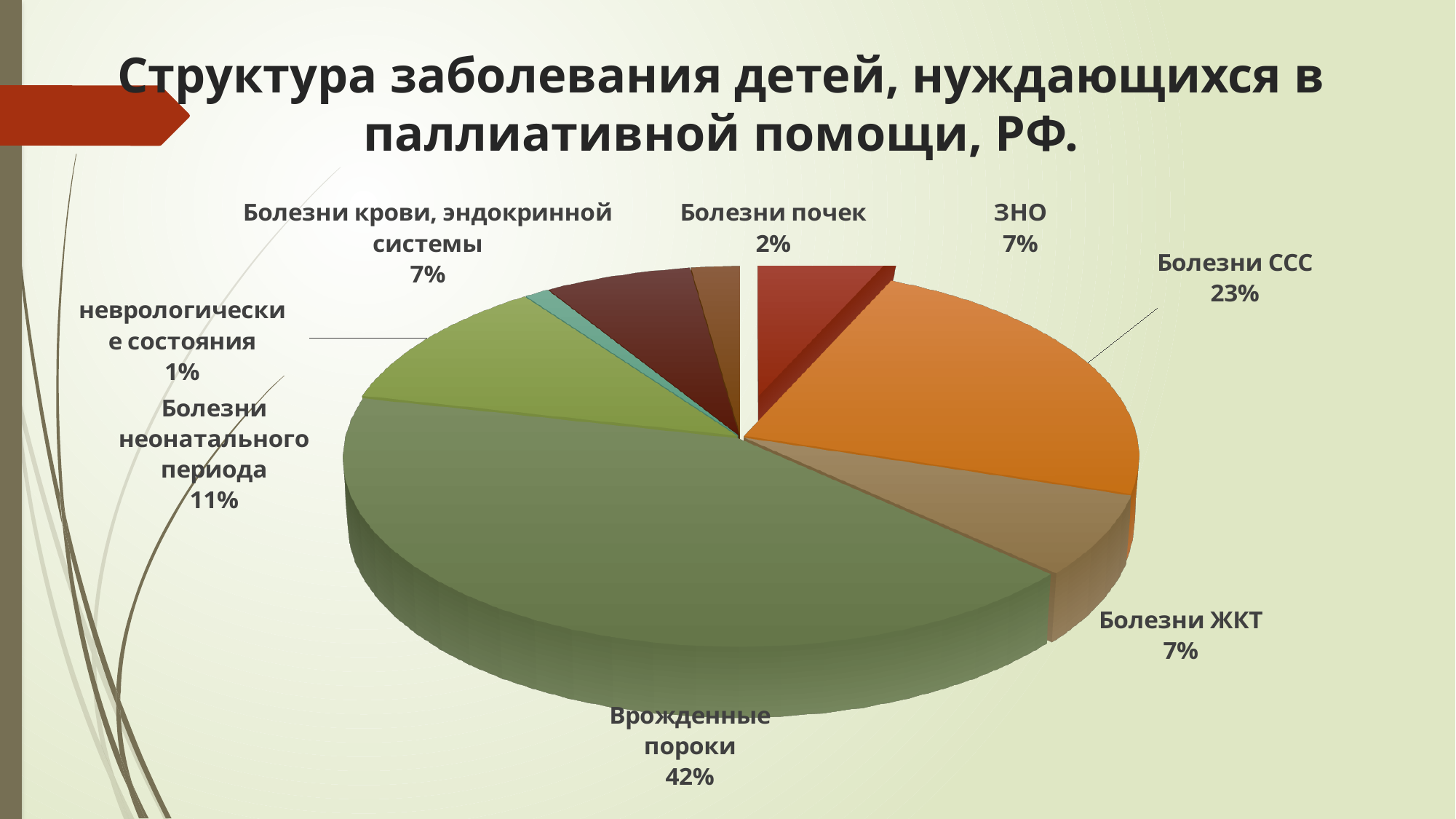
What is the title of the chart on the slide? Структура заболевания детей, нуждающихся в паллиативной помощи, РФ. Which category has the smallest share of the pie? неврологические состояния What share is shown for Болезни неонатального периода? 11% What is the difference in percentage points between Врожденные пороки and Болезни ССС? 19 What share is shown for Болезни почек? 2% How many categories share the value 7%? 3 Which category has the largest share of the pie? Врожденные пороки Which is larger: the share for Болезни неонатального периода or the share for ЗНО? Болезни неонатального периода What share is shown for Болезни ССС? 23% How many categories are shown in the pie chart? 8 What share of the pie is labelled for Врожденные пороки? 42% What type of chart is shown on the slide? Pie chart